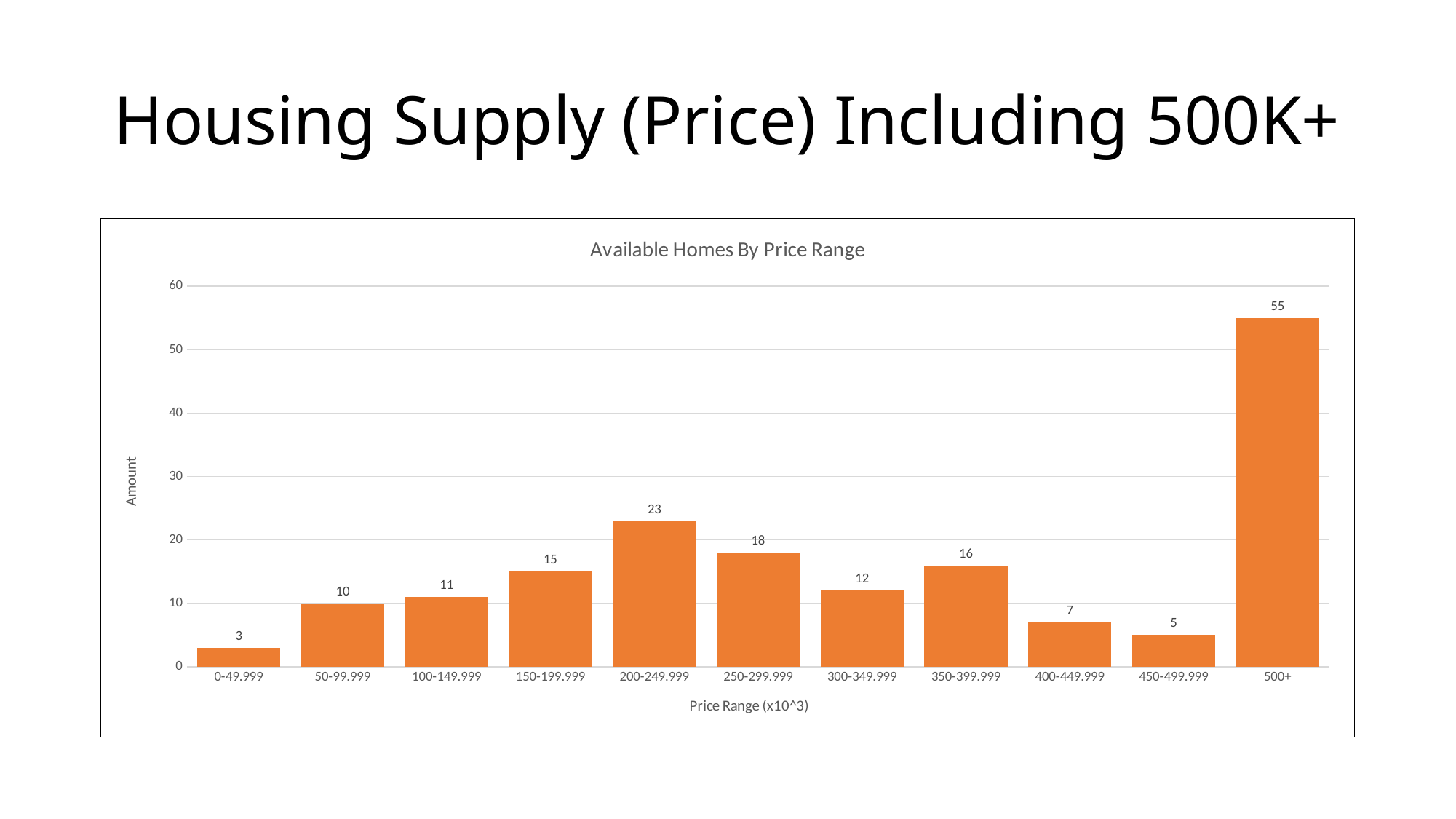
Which price range has the lowest number of available homes? 0-49.999 Is the value for 150-199.999 greater or less than 20? less What is the label of the x axis? Price Range (x10^3) What is the value for the 200-249.999 price range? 23 What is the title of the chart? Available Homes By Price Range What is the value for the 0-49.999 price range? 3 What kind of chart is shown on the slide? bar chart Which is larger, the value for 250-299.999 or the value for 350-399.999? 250-299.999 Which price range has the highest number of available homes? 500+ What is the value for the 500+ price range? 55 What is the difference between the values for 500+ and 200-249.999? 32 How many price range categories are shown on the chart? 11